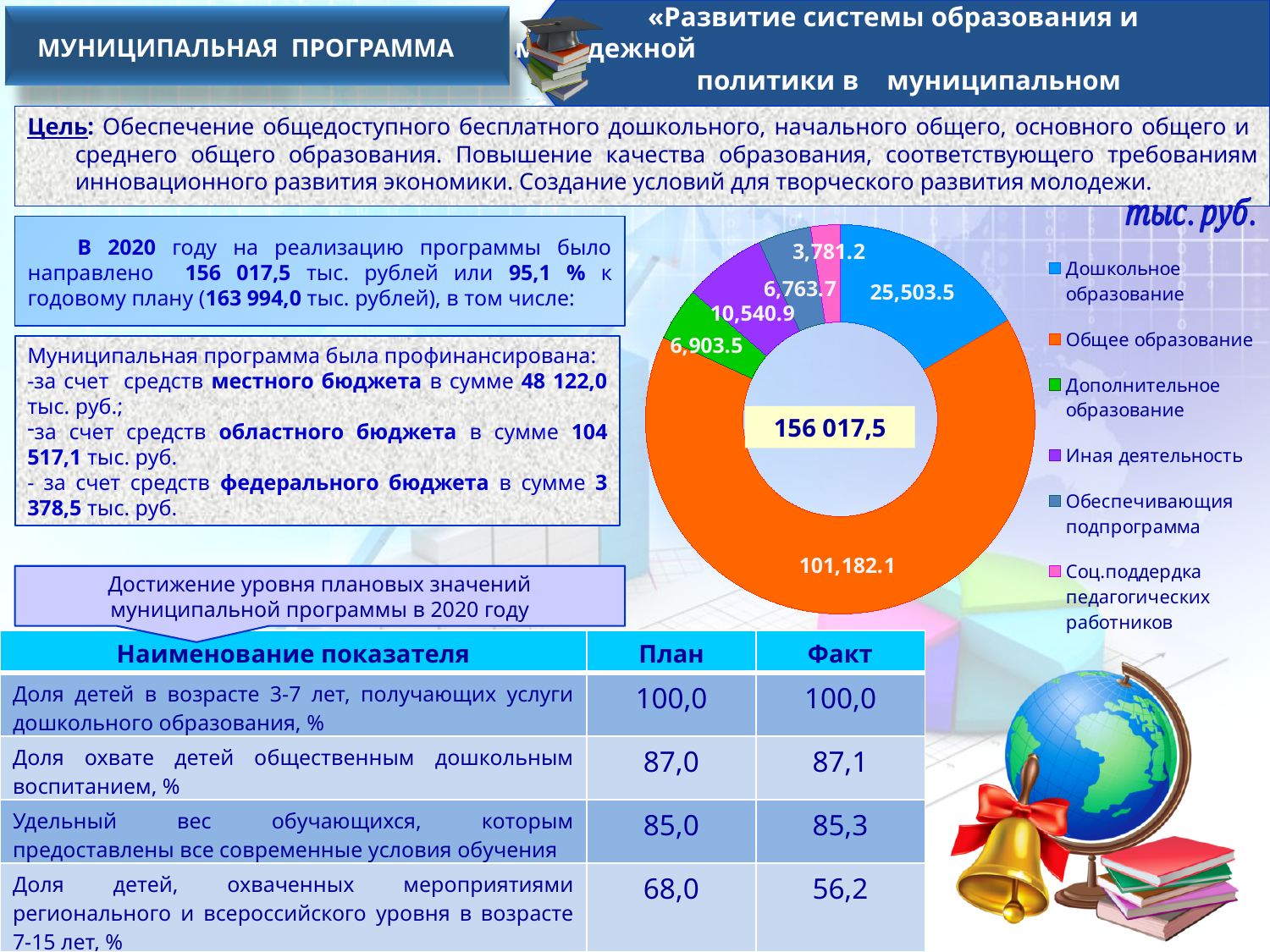
Which category has the smallest slice in the pie chart? Соц.поддержка педагогических работников What is the value for Обеспечивающая подпрограмма in the pie chart? 6,763.7 What kind of chart is shown on the slide? doughnut chart What is the difference between the values for Общее образование and Дошкольное образование? 75,678.6 What is the value for Иная деятельность in the pie chart? 10,540.9 What is the value for Соц.поддержка педагогических работников in the pie chart? 3,781.2 Which is larger: the value for Дошкольное образование or the value for Иная деятельность? Дошкольное образование What is the value for Общее образование in the pie chart? 101,182.1 Which category has the largest slice in the pie chart? Общее образование What total value is printed in the centre of the pie chart? 156 017,5 What is the value for Дошкольное образование in the pie chart? 25,503.5 How many categories does the pie chart legend list? 6